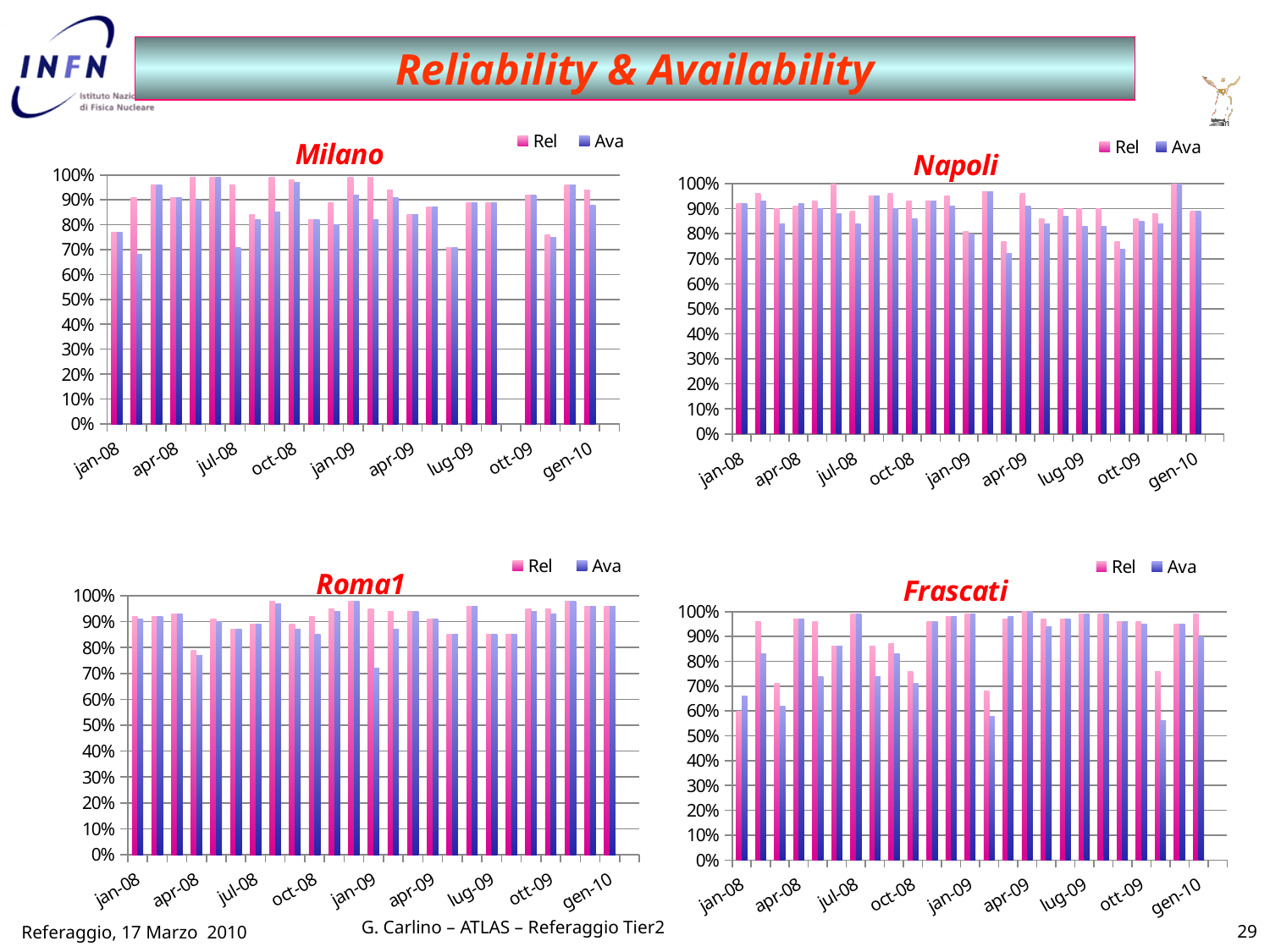
How many charts are shown on the slide? 4 In the Milano chart, is the Rel value for jan-08 greater or less than 80%? less In the Roma1 chart, is the Rel value for apr-08 greater or less than 90%? less How many series does the legend of the Napoli chart list? 2 In the Napoli chart, is the Ava value for apr-09 greater or less than 80%? greater What type of chart is the Milano chart? bar chart What are the two series named in the legend of the Roma1 chart? Rel and Ava